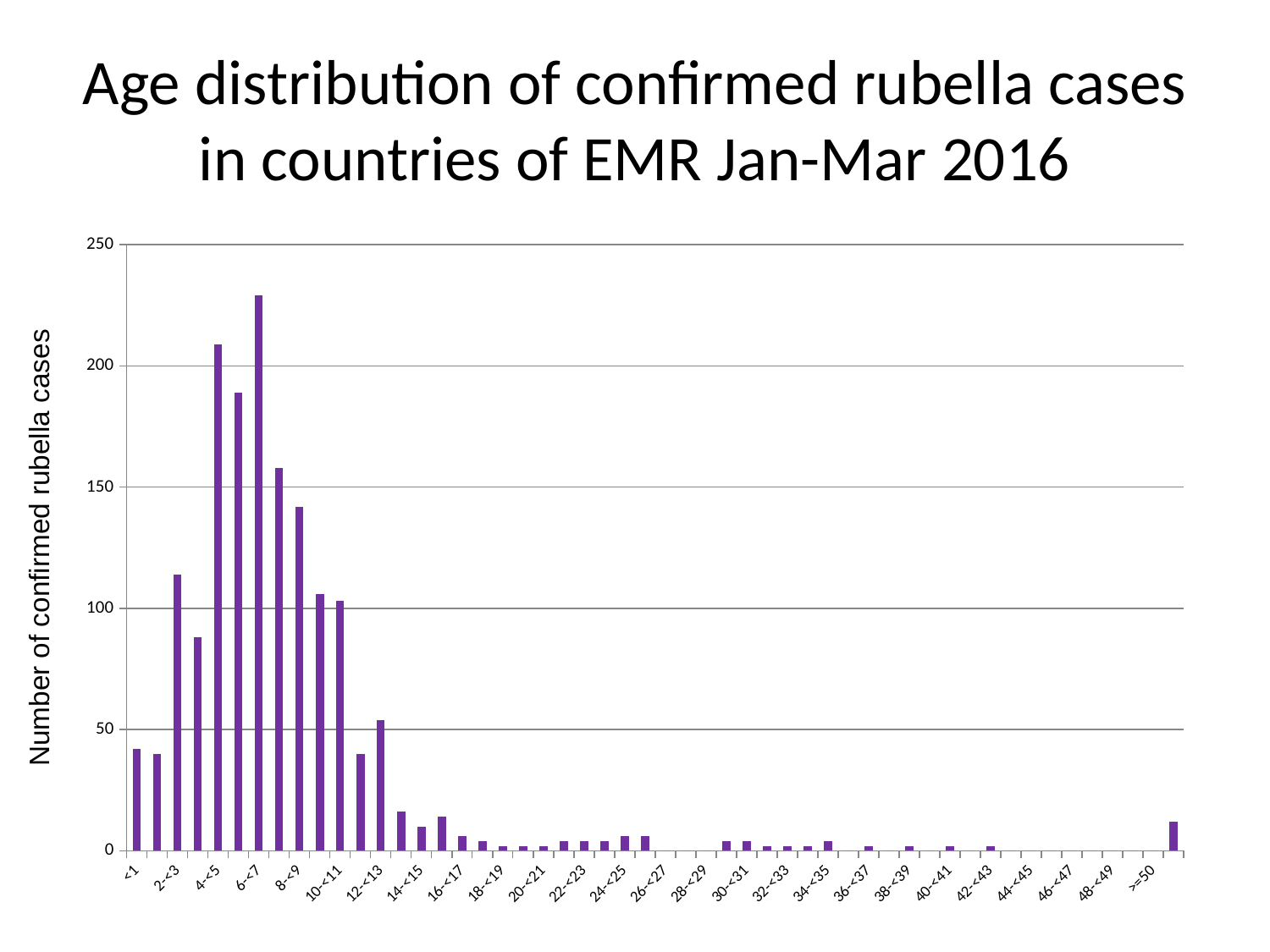
Is the value for the 8-<9 age group greater or less than 150? less Is the value for the >=50 age group greater or less than 50? less What kind of chart is shown on the slide? bar chart What is the label of the vertical axis? Number of confirmed rubella cases Which age group has the highest number of confirmed rubella cases? 6-<7 Is the value for the 6-<7 age group greater or less than 200? greater Which has more confirmed rubella cases, the 6-<7 age group or the 4-<5 age group? 6-<7 Which has more confirmed rubella cases, the 2-<3 age group or the <1 age group? 2-<3 Do the values generally rise or fall from the 6-<7 age group to the 16-<17 age group? fall